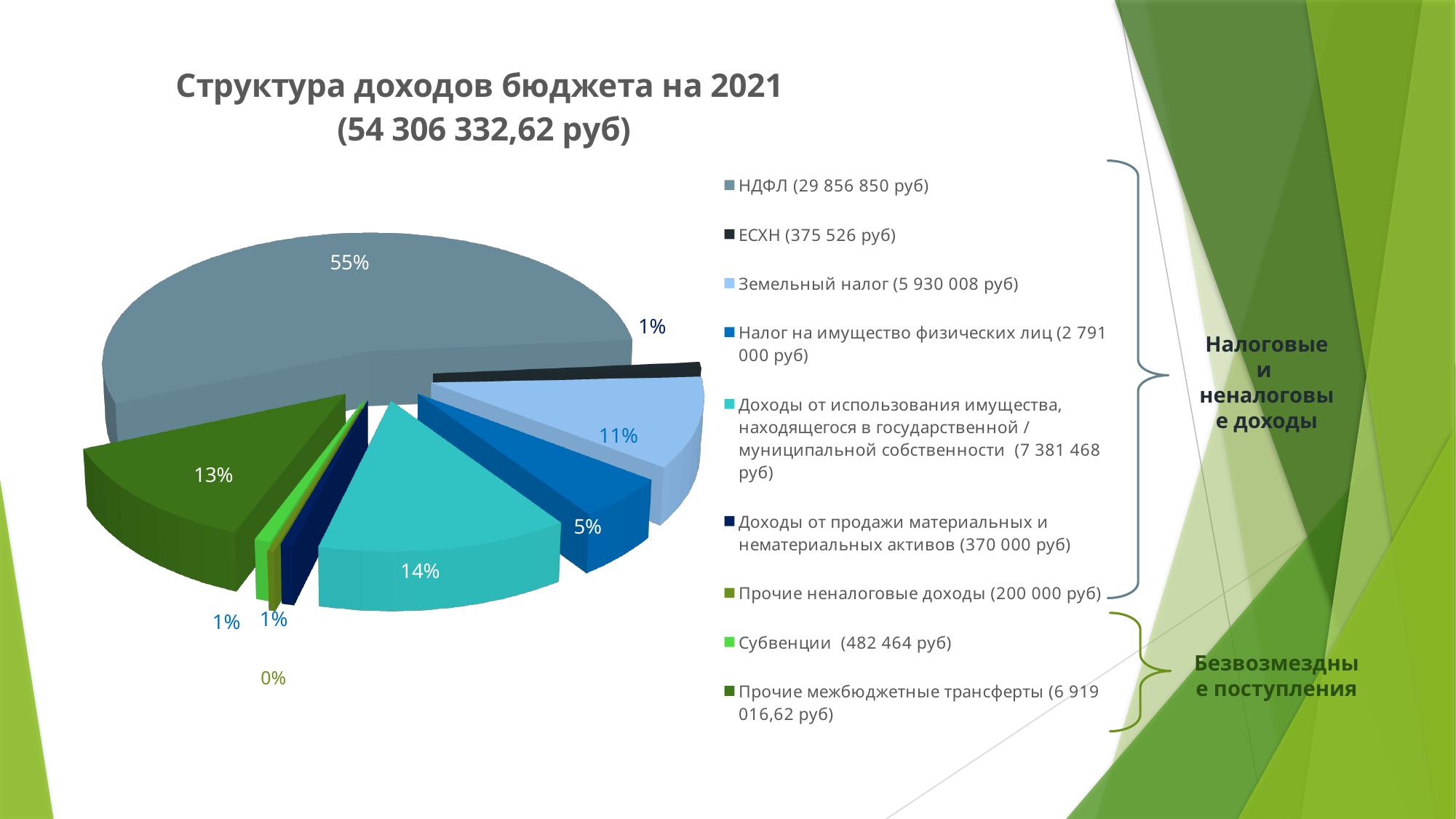
What total budget income amount is given in the chart title? 54 306 332,62 руб What percentage is shown for Прочие межбюджетные трансферты? 13% By how many percentage points does the НДФЛ share exceed the Прочие межбюджетные трансферты share? 42 percentage points Which category has the smallest share of the pie? Прочие неналоговые доходы What percentage is shown for Земельный налог? 11% What percentage is shown for Налог на имущество физических лиц? 5% What share of the budget income does НДФЛ account for? 55% How many categories does the legend list? 9 What kind of chart is shown on the slide? Pie chart Which has the larger share: Земельный налог or Прочие межбюджетные трансферты? Прочие межбюджетные трансферты What share is shown for Доходы от использования имущества, находящегося в государственной / муниципальной собственности? 14% Which category has the largest share of the pie? НДФЛ